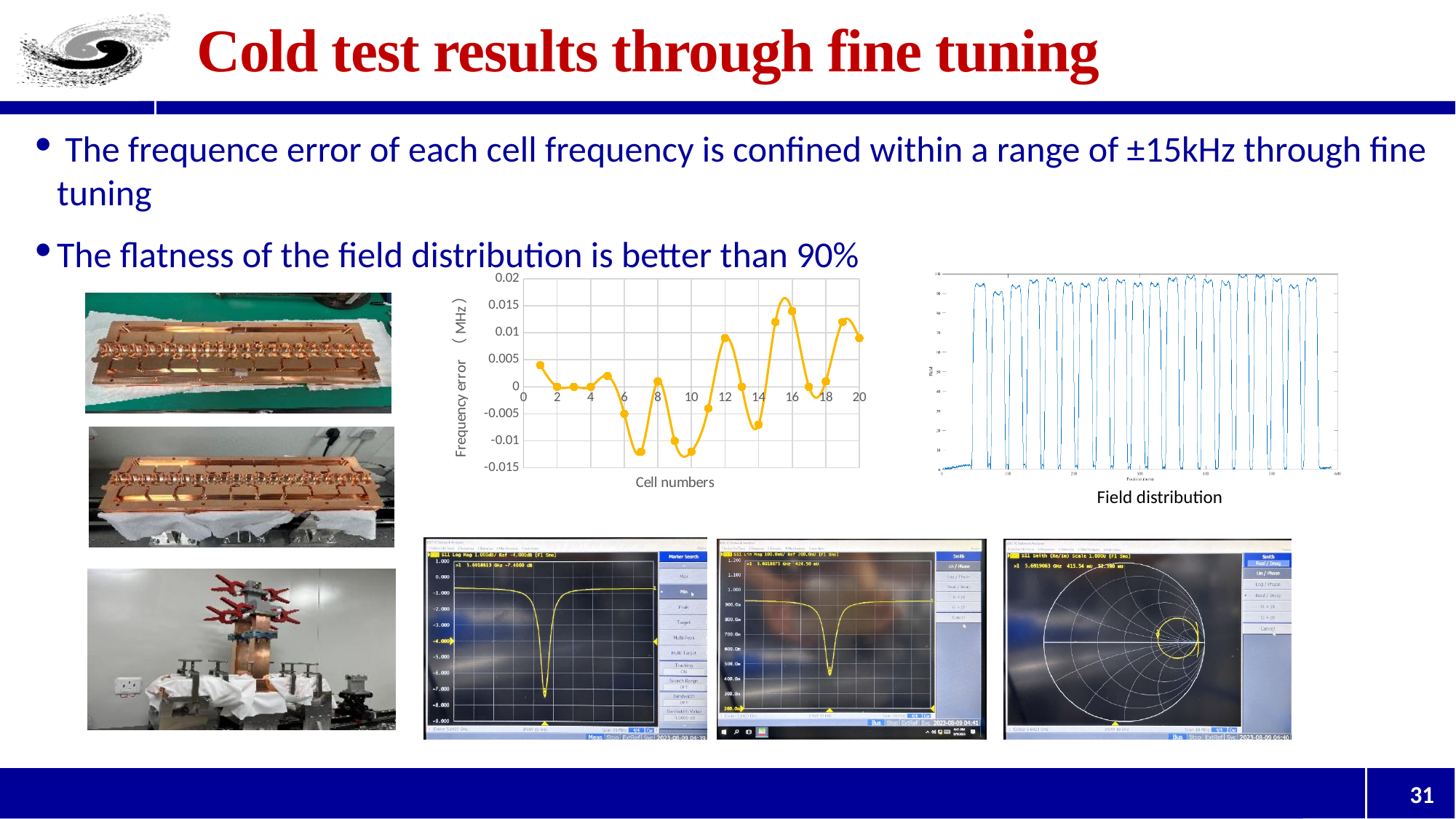
In the frequency error chart, how many data points are plotted? 20 In the frequency error chart, what is the label of the y axis? Frequency error (MHz) In the frequency error chart, which has the larger frequency error, cell 6 or cell 7? cell 6 In the frequency error chart, what is the label of the x axis? Cell numbers In the frequency error chart, which cell number has the highest frequency error? 16 In the frequency error chart, does the frequency error rise or fall from cell 12 to cell 13? fall What kind of chart is the frequency error chart in the middle of the slide? line chart In the frequency error chart, is the value for cell 15 greater or less than 0.01? greater In the frequency error chart, is the value for cell 7 greater or less than -0.01? less In the frequency error chart, is the value for cell 12 greater or less than 0.005? greater In the frequency error chart, which has the larger frequency error, cell 15 or cell 12? cell 15